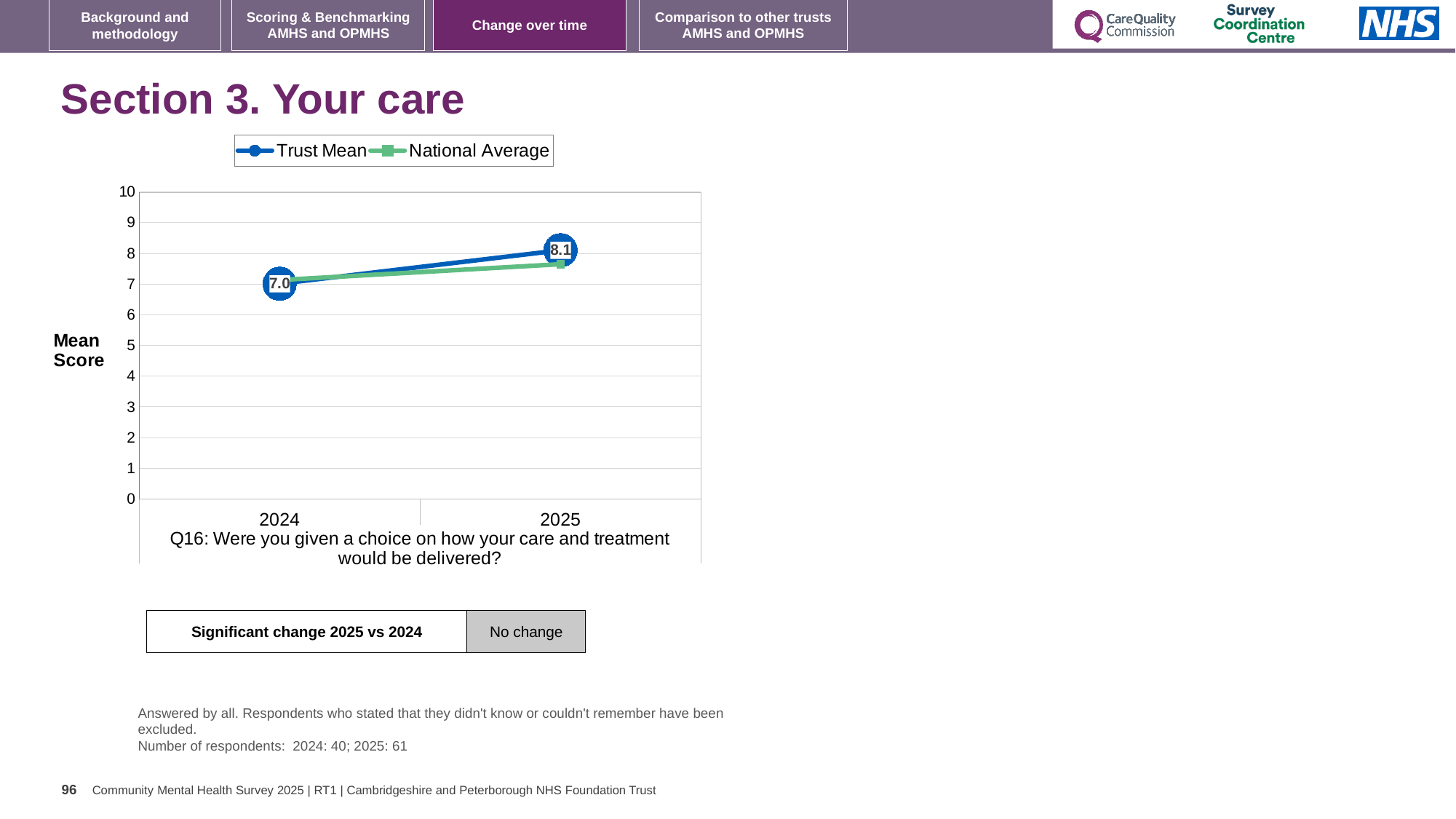
Is the National Average value for 2025 greater or less than 8? less Does the Trust Mean rise or fall from 2024 to 2025? Rise In which year is the Trust Mean score lowest? 2024 By how much did the Trust Mean score change from 2024 to 2025? 1.1 In 2025, which is larger: the Trust Mean or the National Average? Trust Mean What is the Trust Mean score for 2024? 7.0 How many years are shown on the x axis of the chart? 2 How many series does the chart legend list? 2 In which year is the Trust Mean score highest? 2025 Is the National Average value for 2025 greater or less than 7? greater What is the Trust Mean score for 2025? 8.1 What kind of chart is shown on the slide? Line chart